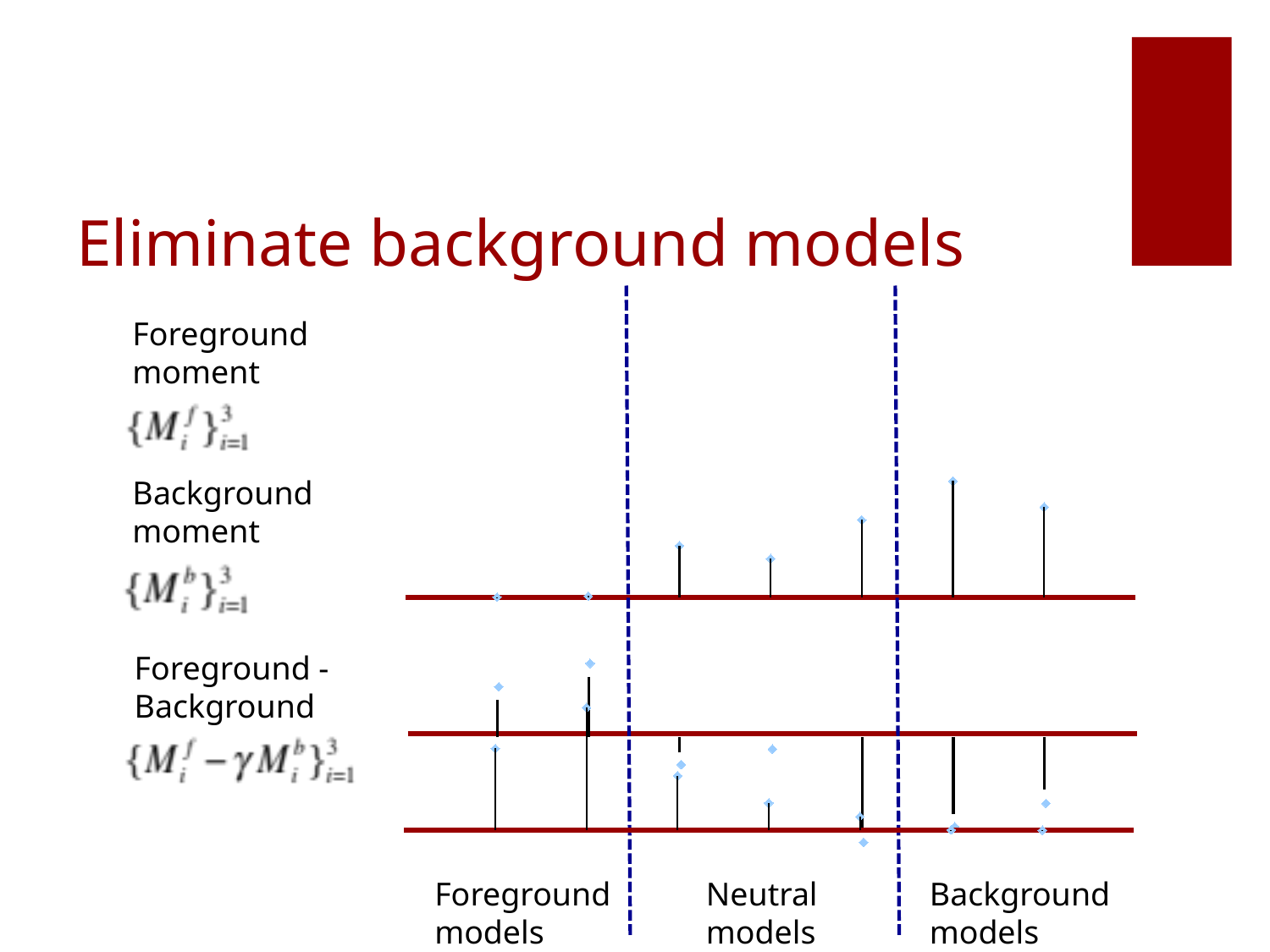
How many dashed vertical lines divide the diagram into model groups? 2 In the upper plot (stems above the top red baseline), which model group has the shortest stems? Foreground models How many model groups are labelled along the bottom of the diagram? 3 What kind of plot is used to show the moments in the diagram? stem plot What are the three model groups labelled along the bottom of the diagram, from left to right? Foreground models, Neutral models, Background models In the upper plot (stems above the top red baseline), which model group has the tallest stems? Background models In the upper plot, do the stem heights rise or fall moving from the foreground models on the left to the background models on the right? rise In the upper plot, are the stems for the neutral models taller or shorter than those for the background models? shorter What is the title of the slide containing the diagram? Eliminate background models